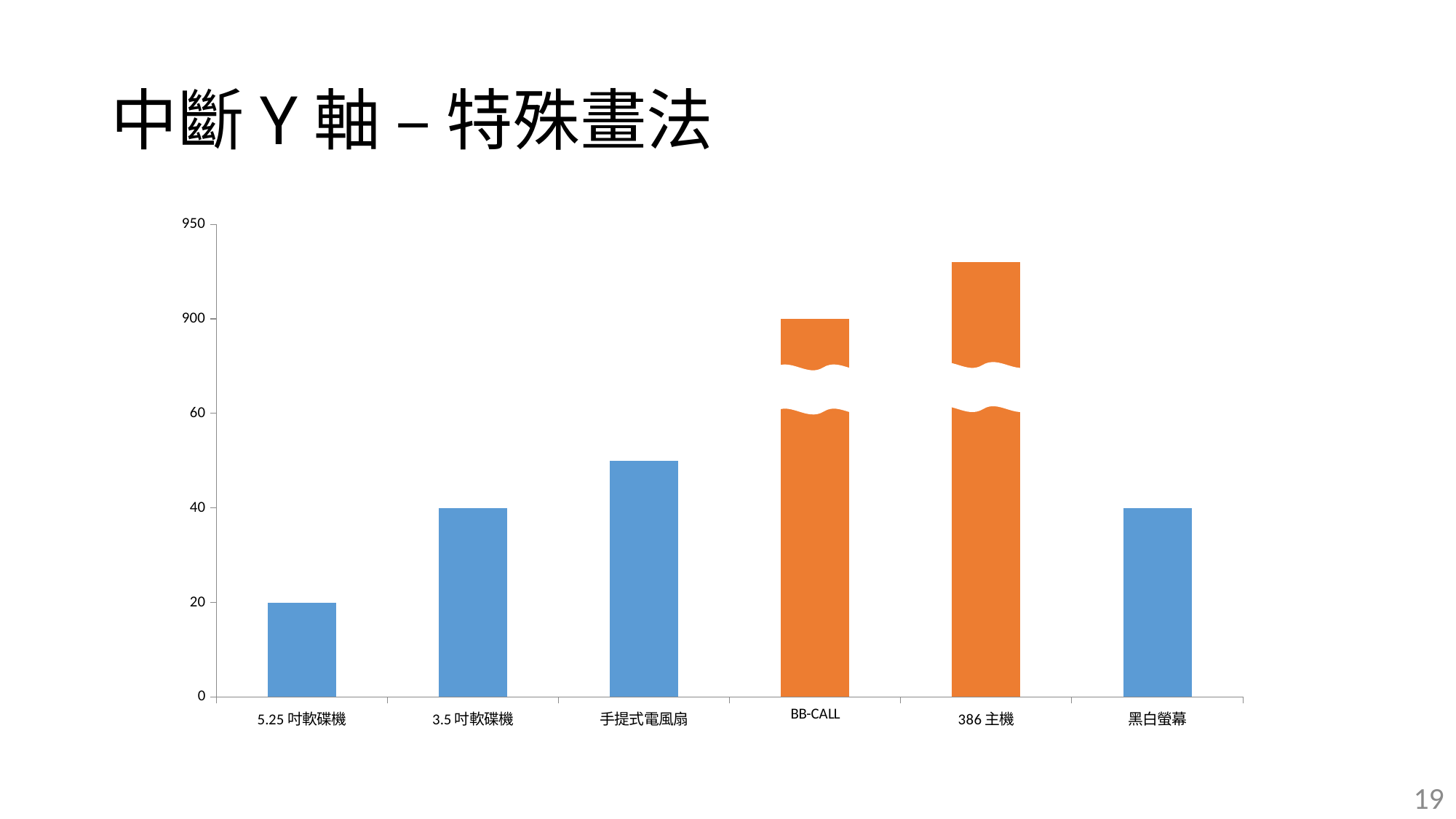
Which is larger, the value for BB-CALL or the value for 手提式電風扇? BB-CALL Is the value for 386 主機 greater or less than 900? greater What is the difference between the values for 3.5 吋軟碟機 and 5.25 吋軟碟機? 20 Which category has the highest value? 386 主機 Is the value for 手提式電風扇 greater or less than 40? greater What is the value for 黑白螢幕? 40 How many categories are shown on the x axis? 6 Which category has the lowest value? 5.25 吋軟碟機 What is the value for 5.25 吋軟碟機? 20 What is the value for 3.5 吋軟碟機? 40 What kind of chart is shown on the slide? bar chart What is the value for BB-CALL? 900